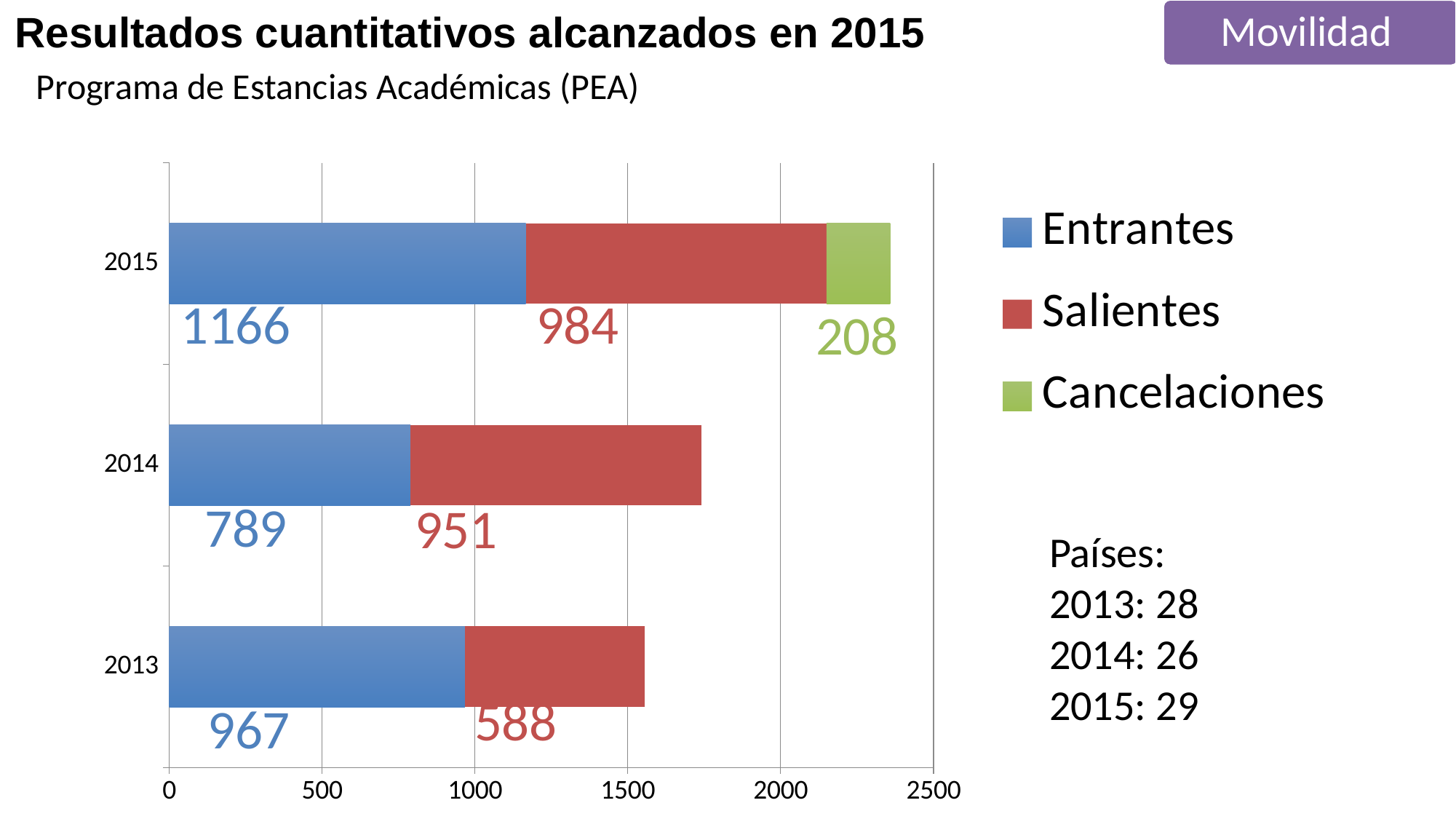
How many years are shown on the chart? 3 What is the Entrantes value for 2015? 1166 What is the total of the stacked bar for 2013? 1555 What is the Salientes value for 2014? 951 Which year has the highest Entrantes value? 2015 How many series does the legend list? 3 What is the difference between the Entrantes values for 2015 and 2014? 377 Which year has the lowest Salientes value? 2013 What kind of chart is shown on the slide? Stacked bar chart Is the total length of the 2014 stacked bar greater or less than 1500? greater What is the Cancelaciones value for 2015? 208 Which is larger for 2014, Entrantes or Salientes? Salientes